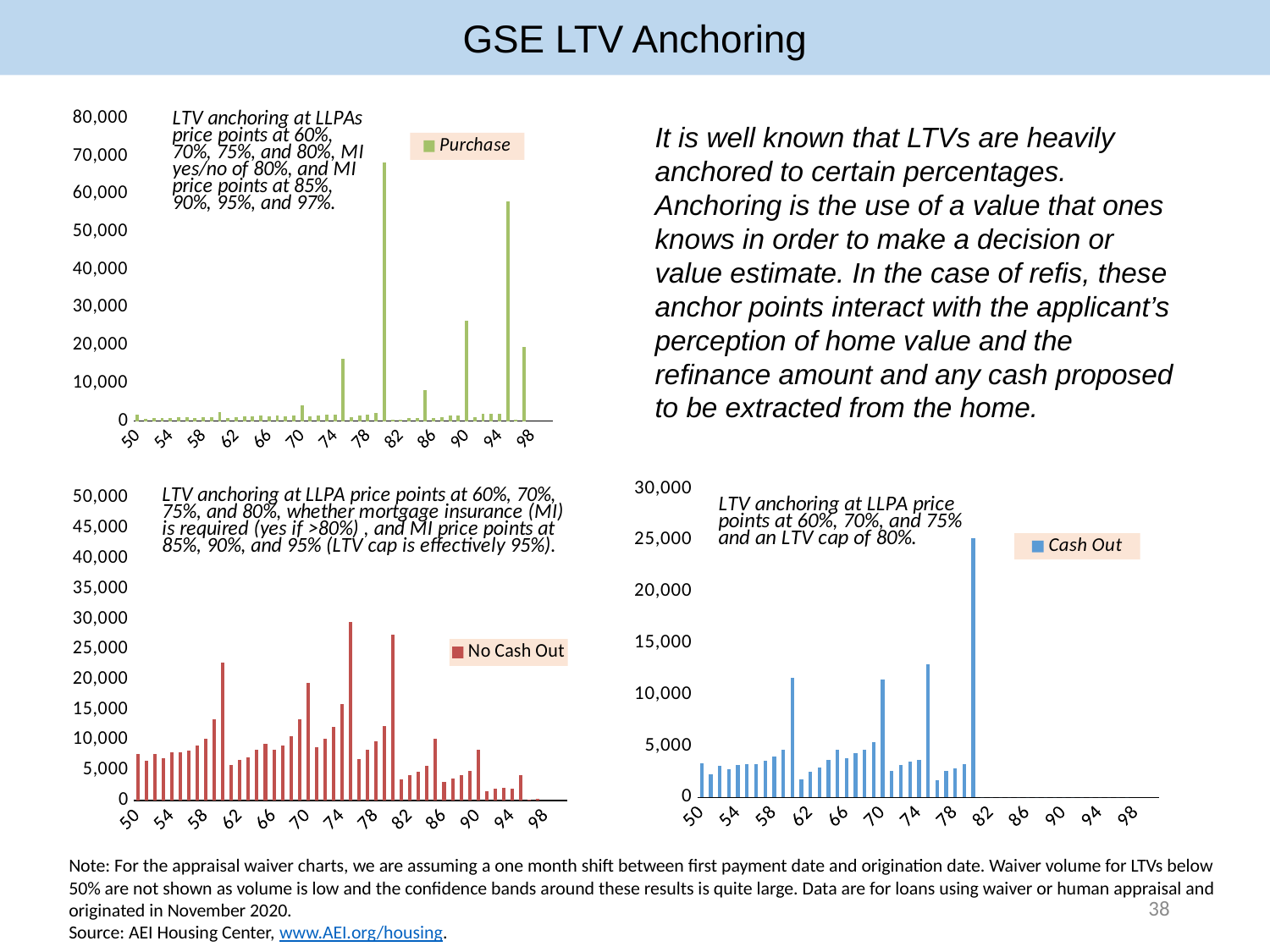
In the No Cash Out chart, which is larger, the value at LTV 70 or at LTV 90? LTV 70 In the No Cash Out chart, is the value at LTV 90 greater or less than 10,000? less In the Purchase chart, is the tallest bar greater or less than 60,000? greater What kind of chart is the Purchase chart at the top left of the slide? bar chart What is the legend entry of the bottom-right chart? Cash Out In the Cash Out chart, is the value at LTV 70 greater or less than 10,000? greater In the Purchase chart, how many series does the legend list? 1 In the Purchase chart, which is larger, the value at LTV 90 or at LTV 70? LTV 90